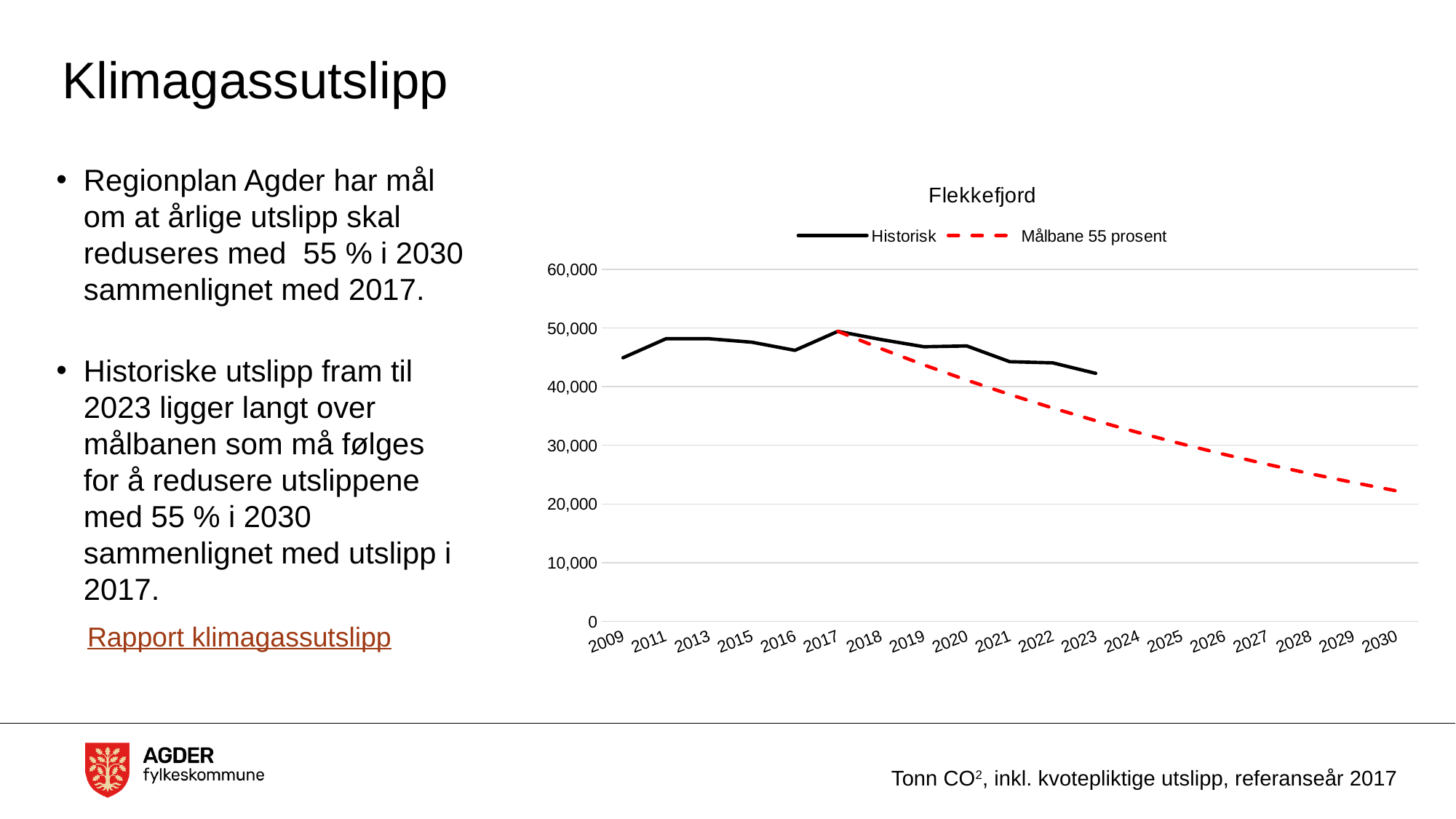
How many series does the chart legend list? 2 In which year does the Historisk series reach its lowest value? 2023 In 2023, which series has the higher value, Historisk or Målbane 55 prosent? Historisk In which year does the Historisk series reach its highest value? 2017 Is the Historisk value for 2023 greater or less than 40,000? greater How many years are labelled on the x axis of the chart? 19 What kind of chart is shown on the slide? line chart Is the Historisk value for 2009 greater or less than 40,000? greater What are the names of the two series in the legend? Historisk and Målbane 55 prosent Is the Målbane 55 prosent value for 2030 greater or less than 30,000? less What is the title of the chart? Flekkefjord Does the Målbane 55 prosent series rise or fall from 2017 to 2030? fall